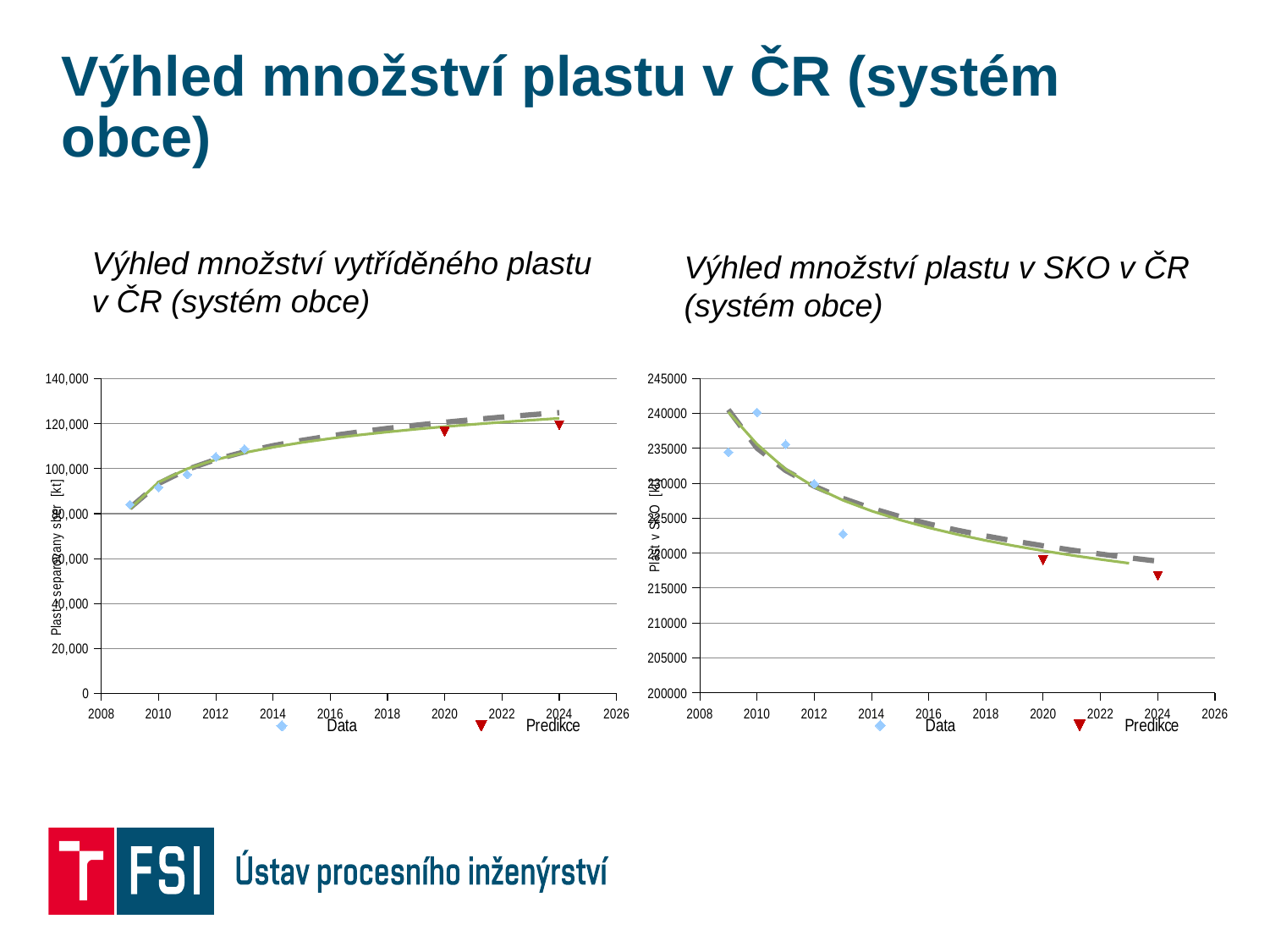
In the right chart (Výhled množství plastu v SKO v ČR), is the Predikce value for 2024 greater or less than 220000? less In the left chart (Výhled množství vytříděného plastu v ČR), is the Data value for 2009 greater or less than 100,000? less In the right chart (Výhled množství plastu v SKO v ČR), how many Predikce points are plotted? 2 In the left chart (Výhled množství vytříděného plastu v ČR), is the Predikce value for 2020 greater or less than 100,000? greater In the left chart (Výhled množství vytříděného plastu v ČR), do the values rise or fall from 2009 to 2024? rise In the right chart (Výhled množství plastu v SKO v ČR), which year has the highest Data value? 2010 In the right chart (Výhled množství plastu v SKO v ČR), do the values rise or fall from 2010 to 2024? fall In the left chart (Výhled množství vytříděného plastu v ČR), which is larger, the Data value for 2009 or the Data value for 2013? 2013 In the left chart (Výhled množství vytříděného plastu v ČR), what are the two legend entries? Data, Predikce In the right chart (Výhled množství plastu v SKO v ČR), how many series does the legend list? 2 In the left chart (Výhled množství vytříděného plastu v ČR), what kind of chart is it? scatter chart